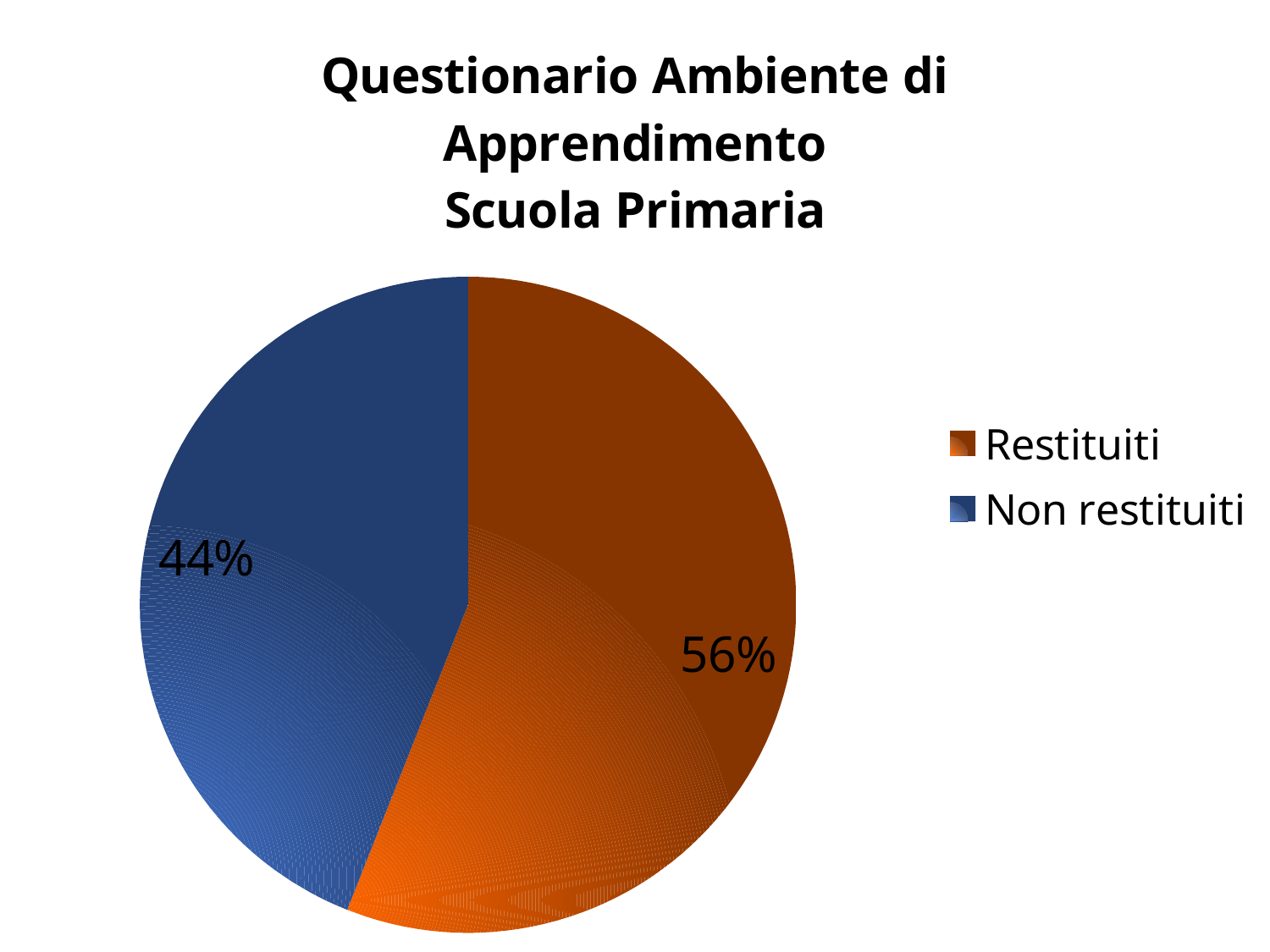
What share of the pie is Restituiti? 56% Which category has the smallest slice of the pie? Non restituiti Which is larger, Restituiti or Non restituiti? Restituiti What is the difference in percentage points between Restituiti and Non restituiti? 12 What kind of chart is shown on the slide? Pie chart How many entries does the legend list? 2 Which category has the largest slice of the pie? Restituiti How many slices does the pie chart have? 2 What colour is the Non restituiti slice? Blue What share of the pie is Non restituiti? 44% What is the title of the chart? Questionario Ambiente di Apprendimento Scuola Primaria